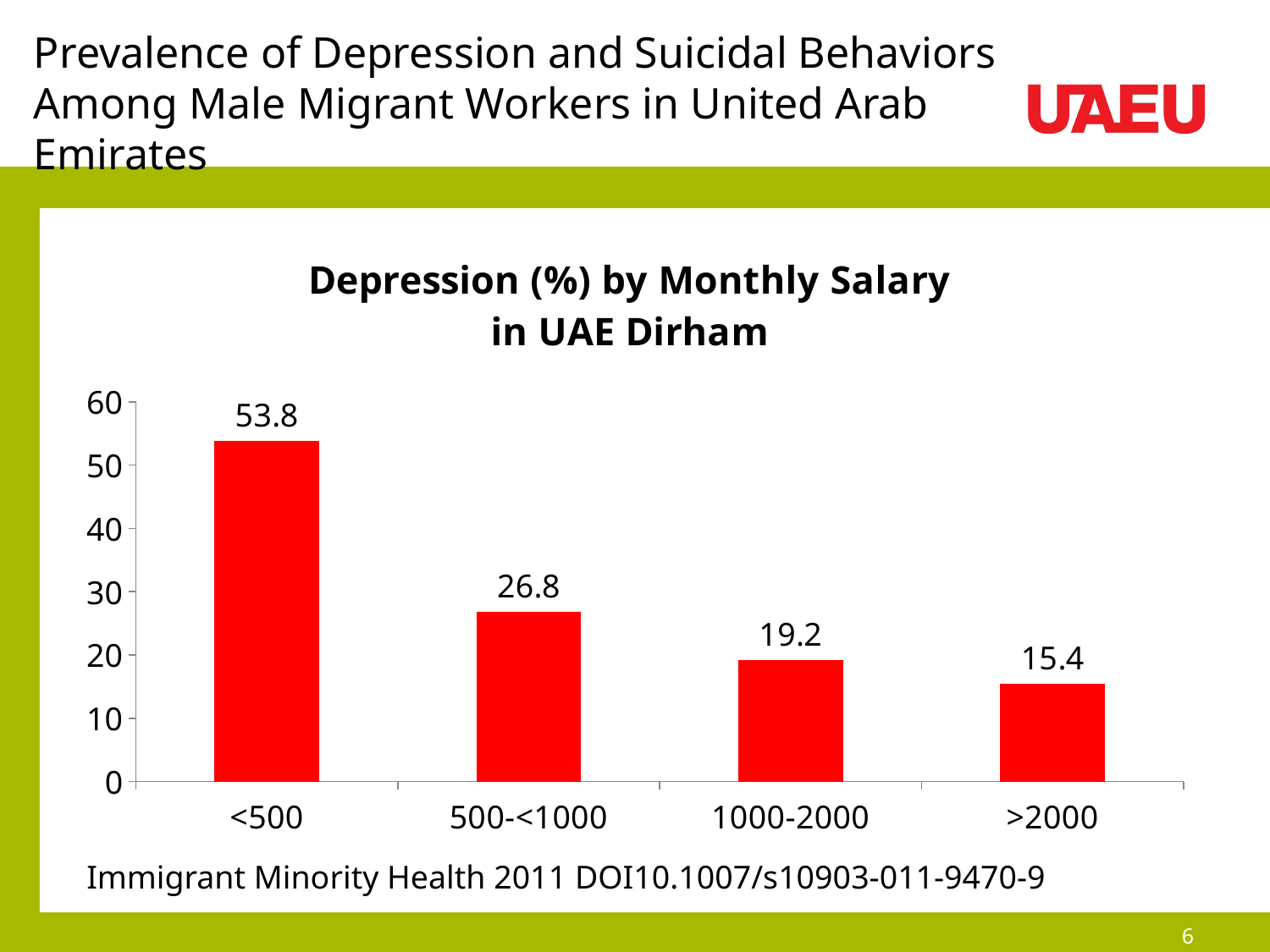
What is the difference in depression percentage between the <500 and 500-<1000 salary groups? 27 What is the depression percentage for the <500 salary group? 53.8 Which salary group has a higher depression percentage, 500-<1000 or 1000-2000? 500-<1000 What is the depression percentage for the 500-<1000 salary group? 26.8 What is the difference in depression percentage between the 1000-2000 and >2000 salary groups? 3.8 What is the depression percentage for the >2000 salary group? 15.4 Which salary group has the lowest depression percentage? >2000 What kind of chart is shown on the slide? Bar chart How many salary groups are shown in the chart? 4 What is the depression percentage for the 1000-2000 salary group? 19.2 Which salary group has the highest depression percentage? <500 Do the depression percentages rise or fall as monthly salary increases along the x axis? Fall